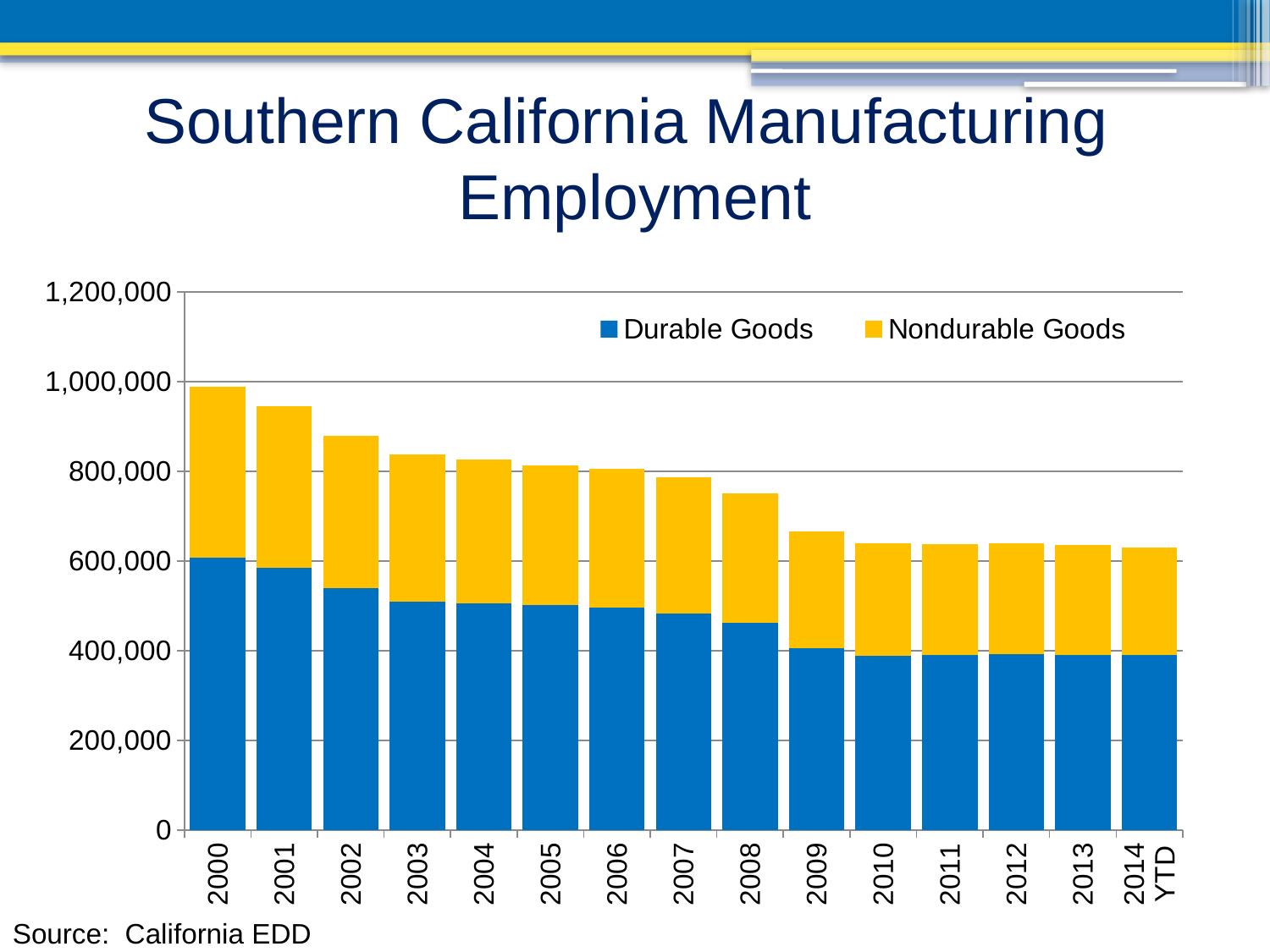
Which year has the highest Durable Goods employment? 2000 Do total manufacturing employment values rise or fall from 2000 to 2014 YTD? Fall Is the total manufacturing employment for 2008 greater or less than 800,000? less What kind of chart is shown on the slide? Stacked bar chart Which year has the highest total manufacturing employment? 2000 Is the Durable Goods value for 2008 greater or less than 400,000? greater Is the total manufacturing employment for 2000 greater or less than 1,000,000? less How many series does the legend list? 2 Which year has the larger total manufacturing employment, 2000 or 2009? 2000 Which series is shown in yellow in the legend? Nondurable Goods How many years (categories) are shown on the x axis? 15